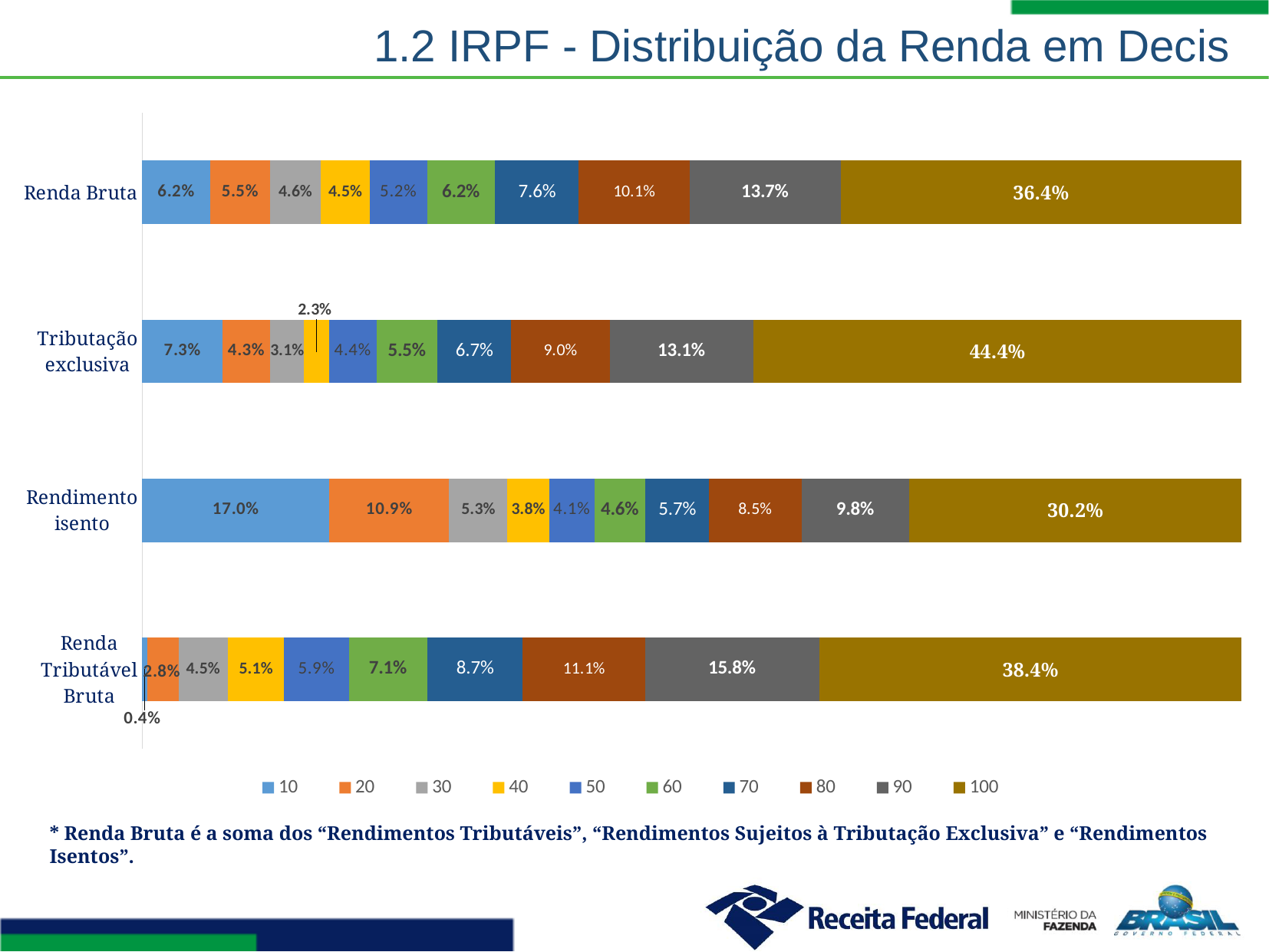
Which is larger: the 90 series value for Renda Tributável Bruta or for Renda Bruta? Renda Tributável Bruta How many series does the legend list? 10 Which category has the highest value for the 100 series? Tributação exclusiva What is the value for the 10 series in the Rendimento isento bar? 17.0% What is the value for the 10 series in the Renda Tributável Bruta bar? 0.4% What is the difference between the 100 series values for Tributação exclusiva and Rendimento isento? 14.2% What kind of chart is shown on the slide? Stacked bar chart How many categories (bars) does the chart show? 4 What is the value for the 40 series in the Tributação exclusiva bar? 2.3% Which category has the lowest value for the 10 series? Renda Tributável Bruta What is the value for the 100 series in the Renda Bruta bar? 36.4% What is the total of the Renda Bruta stacked bar? 100.0%